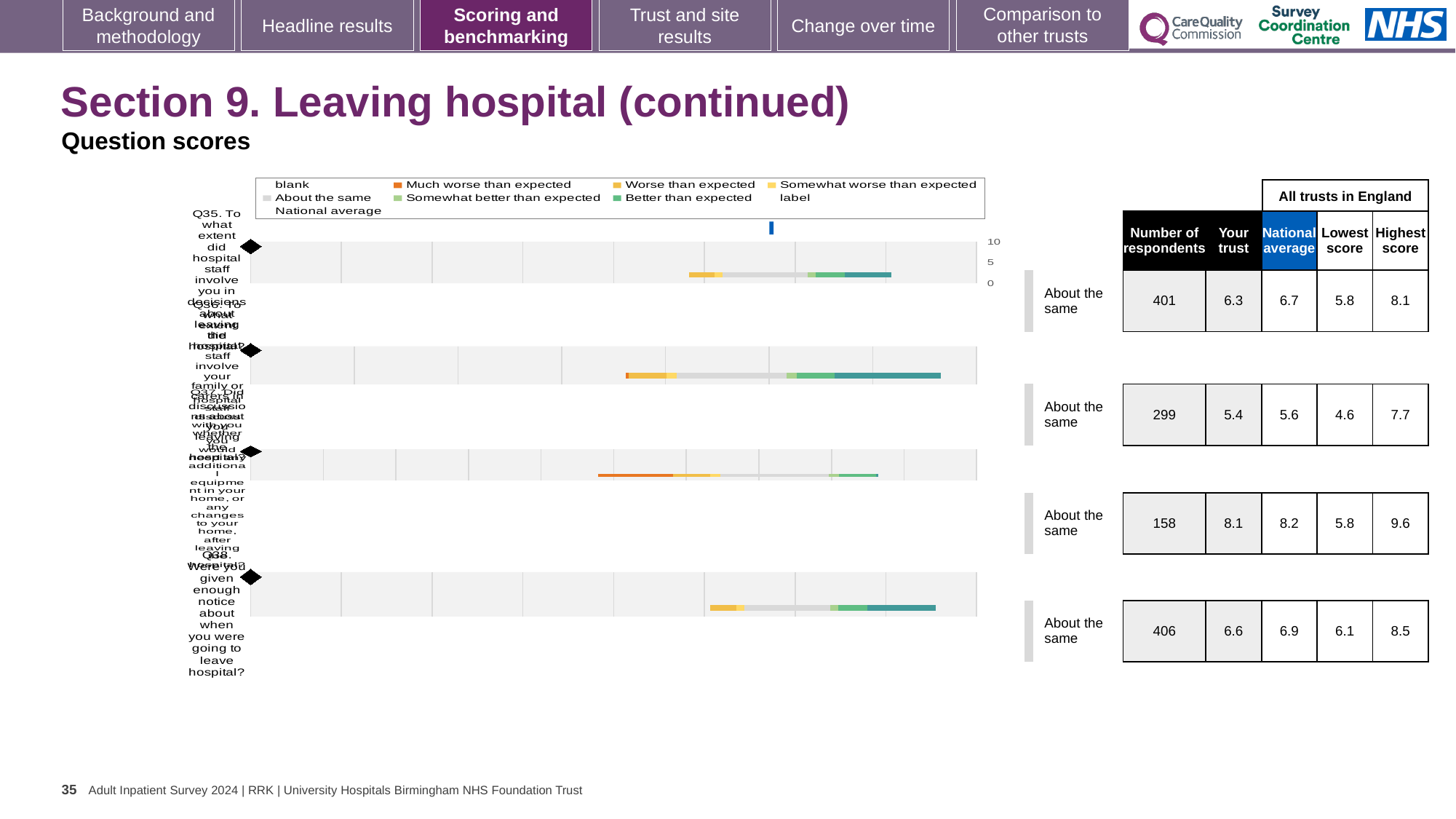
For Q38, what is the difference between the highest and lowest scores across all trusts in England? 2.4 Which question row has the highest 'Your trust' score? The third row (158 respondents), 8.1 For Q38, which is larger: the 'Your trust' score or the national average? National average How many respondents are listed for Q35 (To what extent did hospital staff involve you in decisions about leaving the hospital?)? 401 What benchmark category is shown for Q35? About the same What is the national average score for Q38 (Were you given enough notice about when you were going to leave hospital?)? 6.9 What is the highest score across all trusts in England for the third question row (158 respondents)? 9.6 Which question row has the lowest 'Your trust' score? The second row (299 respondents), 5.4 What is the lowest score across all trusts in England for Q38? 6.1 What is the 'Your trust' score for Q35? 6.3 For Q35, how much higher is the national average than the 'Your trust' score? 0.4 How many question rows are plotted on the chart? 4